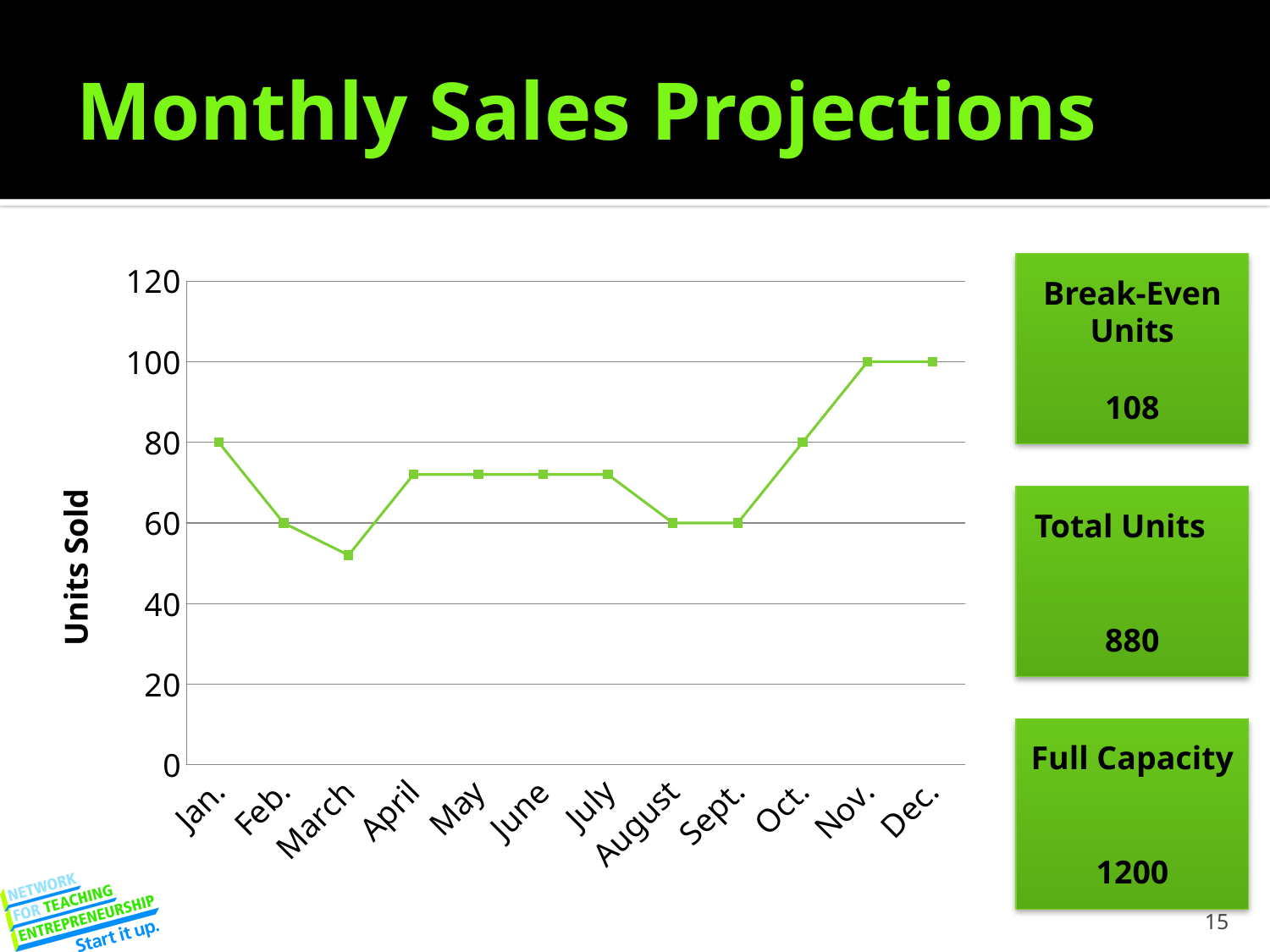
What kind of chart is shown on the slide? line chart What is the value for Jan. in the Monthly Sales Projections chart? 80 Is the value for April greater or less than 80? less What is the value for Nov. in the Monthly Sales Projections chart? 100 How many months are plotted on the x axis of the chart? 12 What is the difference between the value for Nov. and the value for Jan.? 20 What is the label on the y axis of the chart? Units Sold What is the value for Feb. in the Monthly Sales Projections chart? 60 Which month has the lowest value in the chart? March Which is larger, the value for Jan. or the value for Feb.? Jan. Is the value for March greater or less than 60? less Do the values rise or fall from Sept. to Nov.? rise